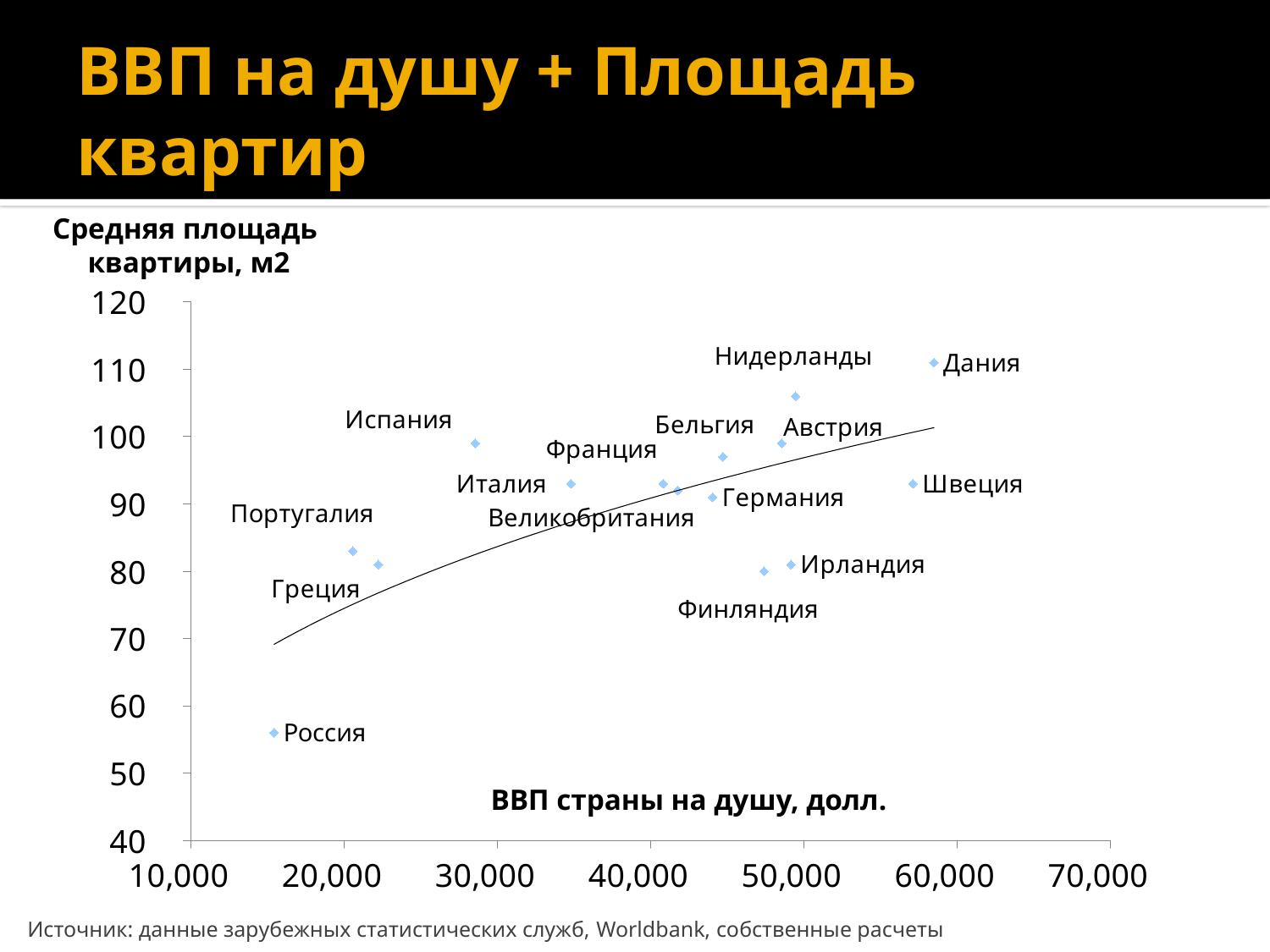
How many countries are plotted on the chart? 15 Is the average apartment area for Нидерланды greater or less than 100? greater Is the average apartment area for Россия greater or less than 60? less Which country has the largest average apartment area on the chart? Дания What is the title of the horizontal axis? ВВП страны на душу, долл. Which country has the smallest average apartment area on the chart? Россия What kind of chart is shown on the slide? Scatter chart Is the average apartment area for Финляндия greater or less than 90? less Which country has the lowest GDP per capita on the chart? Россия According to the trend line, does average apartment area rise or fall as GDP per capita increases? rises Which has the larger average apartment area, Дания or Швеция? Дания